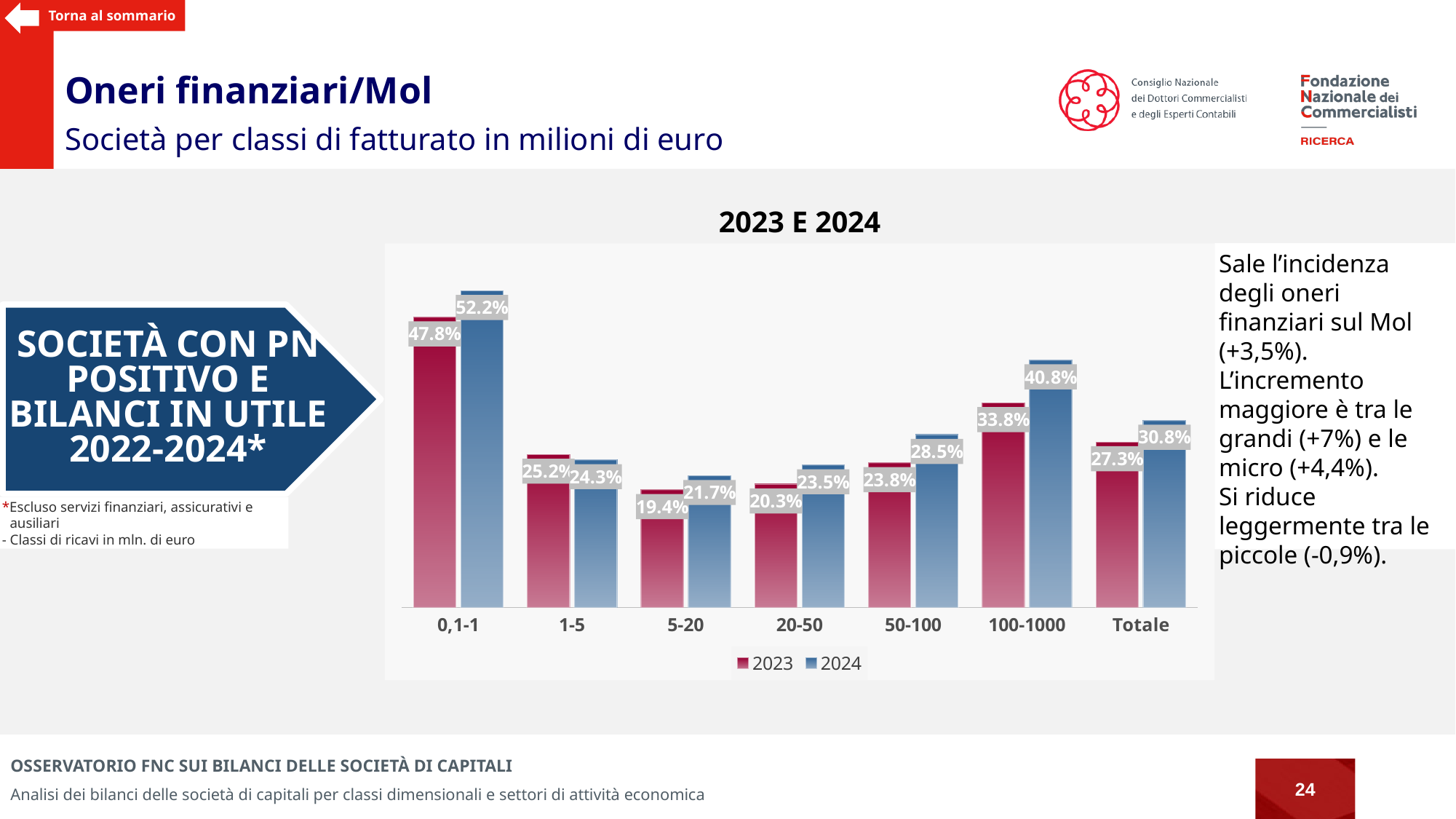
What is the value for 2023 in the Totale category? 27.3% Which class has the highest value for 2024? 0,1-1 How many series does the legend list? 2 What is the value for 2024 in the 0,1-1 class? 52.2% What is the value for 2023 in the 100-1000 class? 33.8% What kind of chart is shown on the slide? Bar chart How many categories are shown on the x axis? 7 What is the value for 2024 in the 50-100 class? 28.5% Which class has the lowest value for 2023? 5-20 What is the difference between the 2024 and 2023 values in the 100-1000 class? 7.0 percentage points What is the difference between the 2024 and 2023 values for Totale? 3.5 percentage points In the 1-5 class, which year has the larger value, 2023 or 2024? 2023